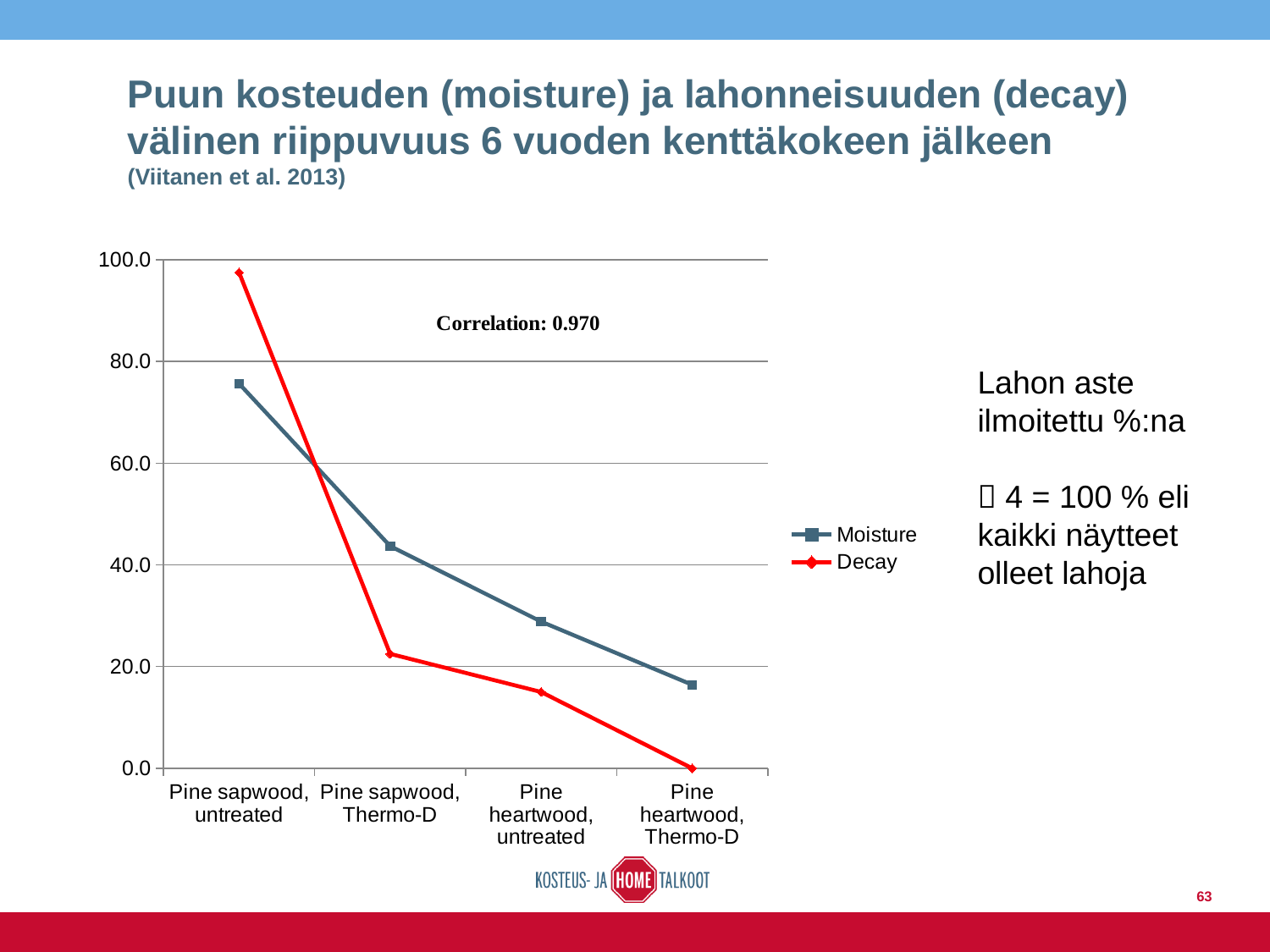
How many categories are shown on the x axis? 4 Which category has the highest Decay value? Pine sapwood, untreated What correlation value is printed on the chart? 0.970 For Pine heartwood, untreated, which is larger: the Moisture value or the Decay value? Moisture Which category has the lowest Moisture value? Pine heartwood, Thermo-D Is the Moisture value for Pine sapwood, Thermo-D greater or less than 60.0? less Do the Moisture values rise or fall from left to right along the x axis? Fall Is the Decay value for Pine sapwood, untreated greater or less than 80.0? greater What is the Decay value for Pine heartwood, Thermo-D? 0.0 What kind of chart is shown on the slide? Line chart Which two series are listed in the legend? Moisture and Decay How many series does the legend list? 2